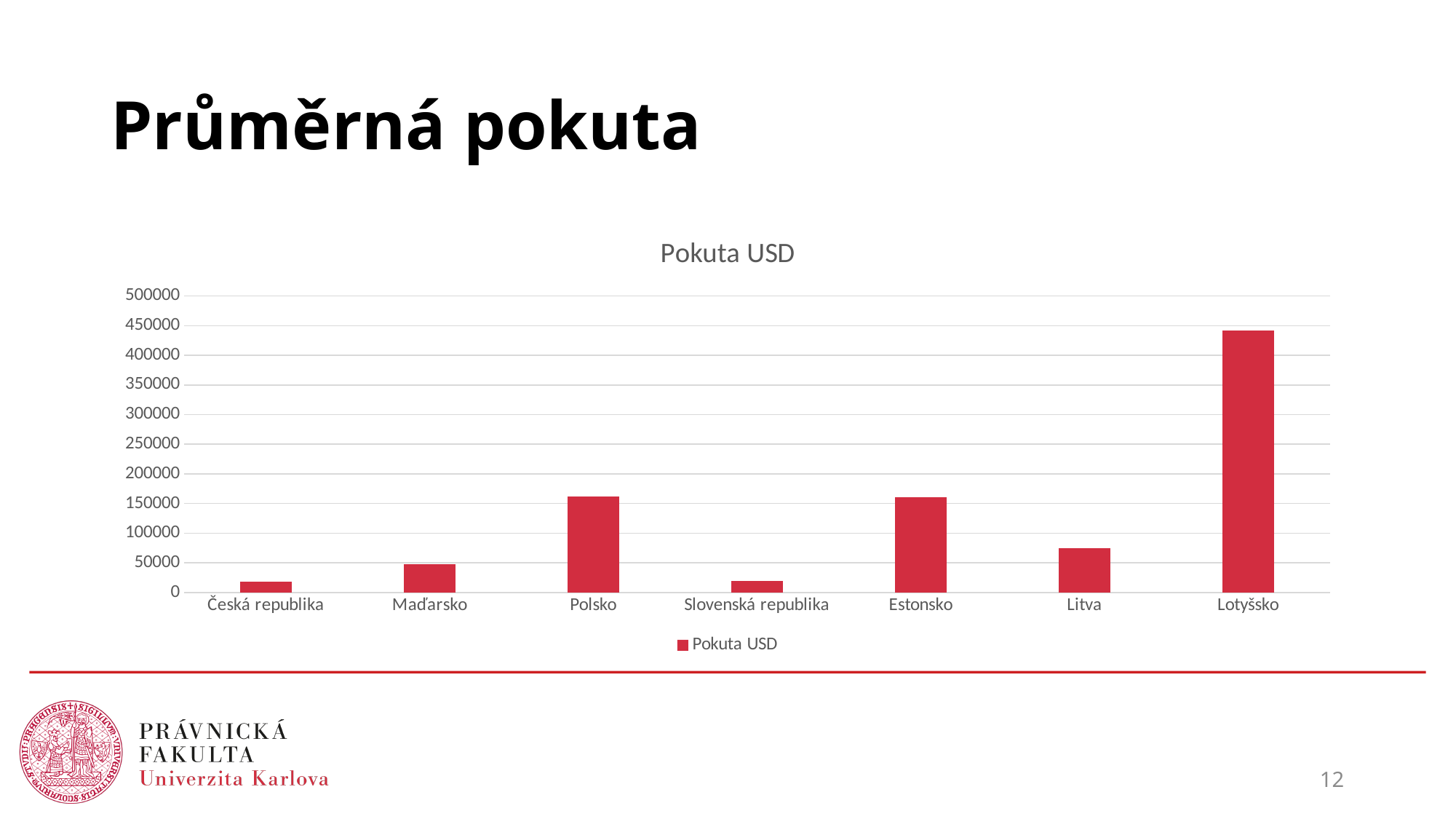
Is the value for Polsko greater or less than 150000? greater How many countries are shown on the x axis of the chart? 7 Which has a larger value, Polsko or Litva? Polsko Is the value for Lotyšsko greater or less than 400000? greater What is the title of the chart? Pokuta USD Which country has the highest value in the chart? Lotyšsko What type of chart is shown on the slide? bar chart How many series does the chart legend list? 1 Which has a larger value, Litva or Maďarsko? Litva Is the value for Maďarsko greater or less than 100000? less